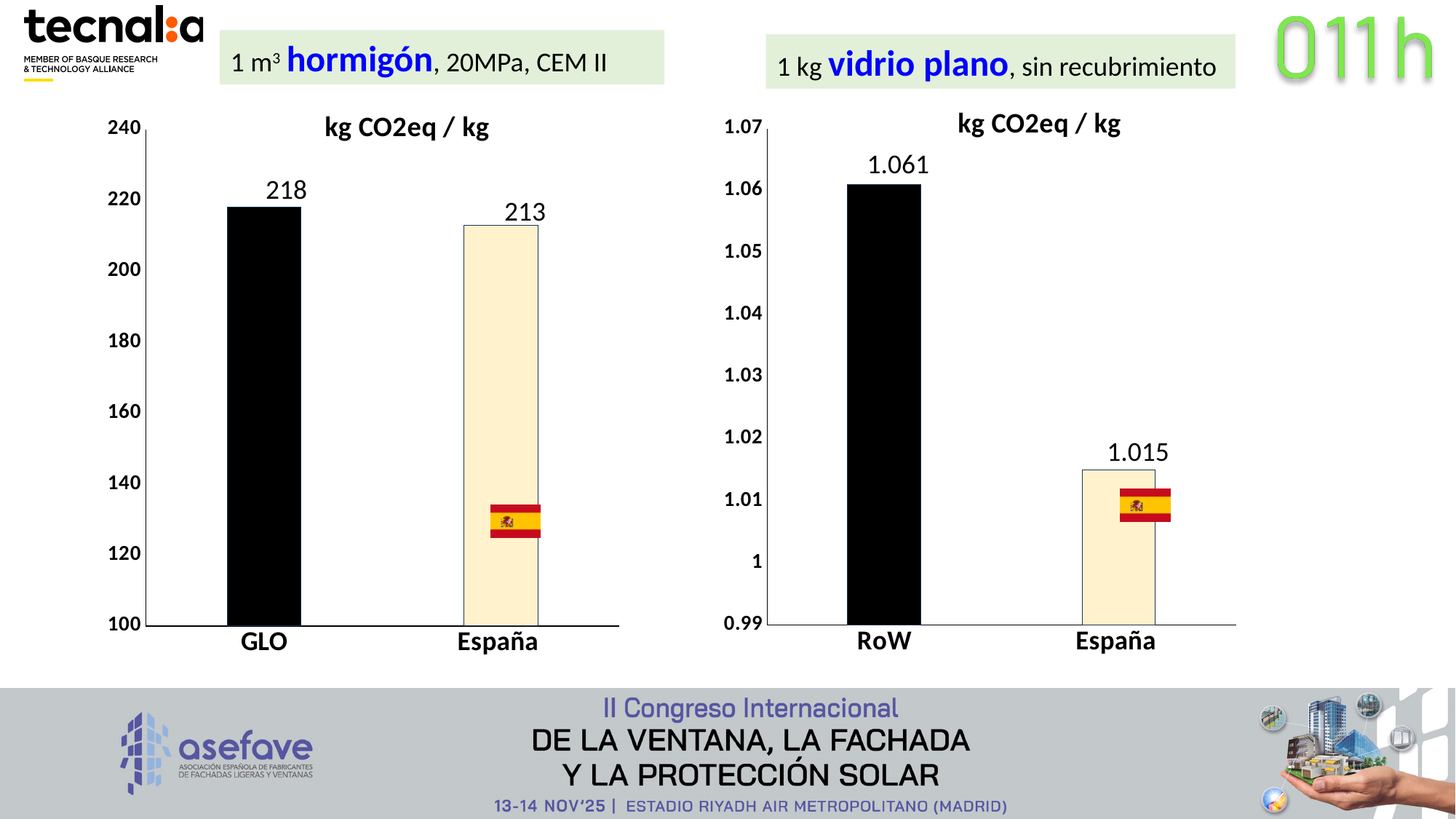
In the left chart (hormigón), what is the value for GLO? 218 In the right chart (vidrio plano), what is the difference between the RoW and España values? 0.046 In the right chart (vidrio plano), what is the value for España? 1.015 In the left chart (hormigón), what is the value for España? 213 In the right chart (vidrio plano), which is larger, RoW or España? RoW In the left chart (hormigón), what is the difference between the GLO and España values? 5 What kind of chart is the right chart (vidrio plano)? Bar chart In the left chart (hormigón), which category has the highest value? GLO In the left chart (hormigón), how many bars are plotted? 2 In the right chart (vidrio plano), which category has the lowest value? España In the right chart (vidrio plano), what is the value for RoW? 1.061 What is the title shown above the left chart (hormigón)? kg CO2eq / kg